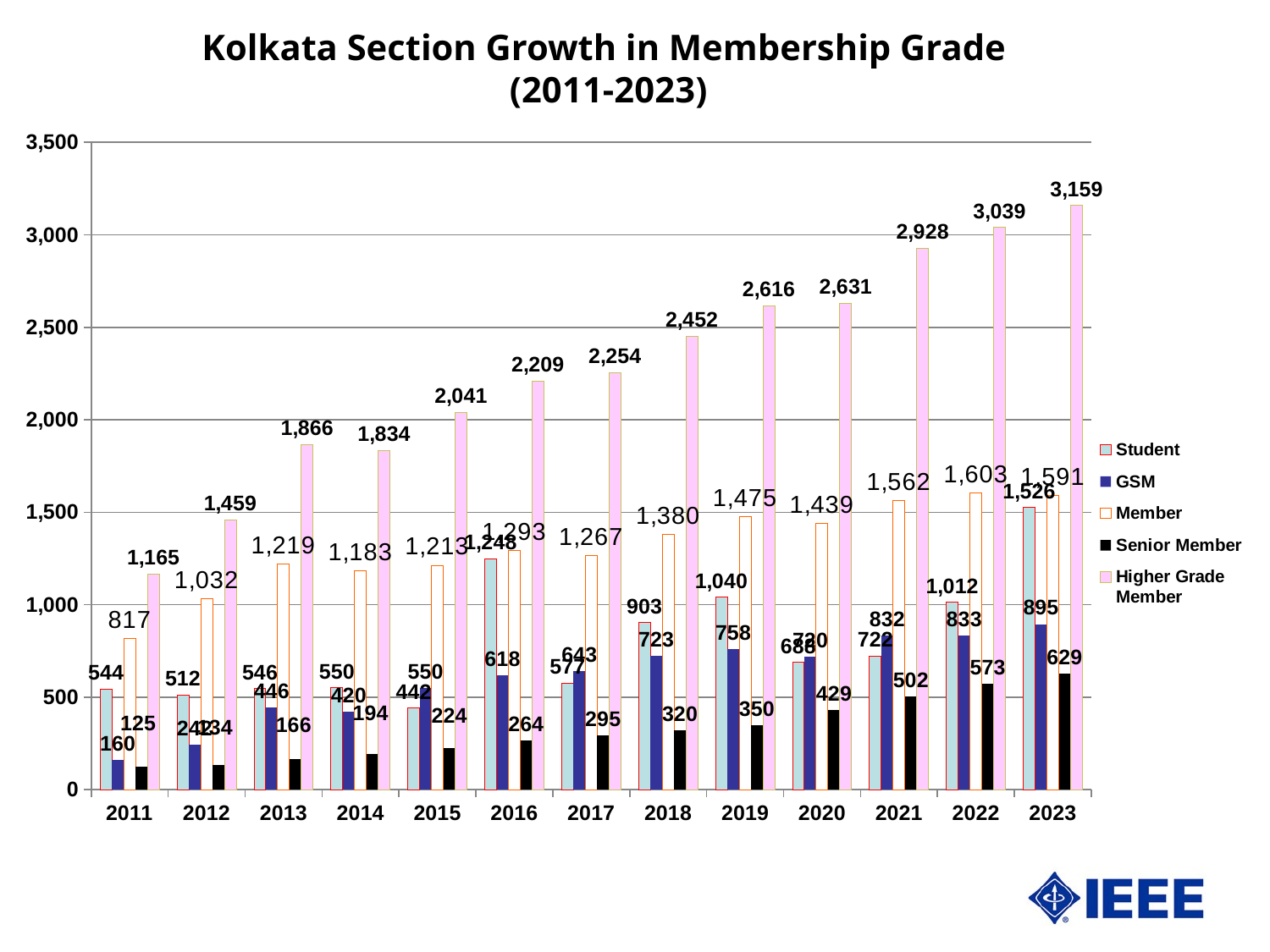
How many years are shown on the x axis? 13 What is the difference between the Higher Grade Member values for 2023 and 2022? 120 In which year is the Higher Grade Member value highest? 2023 What is the value for Member in 2022? 1,603 In 2023, which is larger: the Student value or the Member value? Member What is the title of the chart? Kolkata Section Growth in Membership Grade (2011-2023) What is the value for Higher Grade Member in 2023? 3,159 What kind of chart is shown on the slide? bar chart In which year is the Senior Member value lowest? 2011 What is the value for Senior Member in 2019? 350 How many series does the legend list? 5 Do the Senior Member values rise or fall from 2011 to 2023? rise